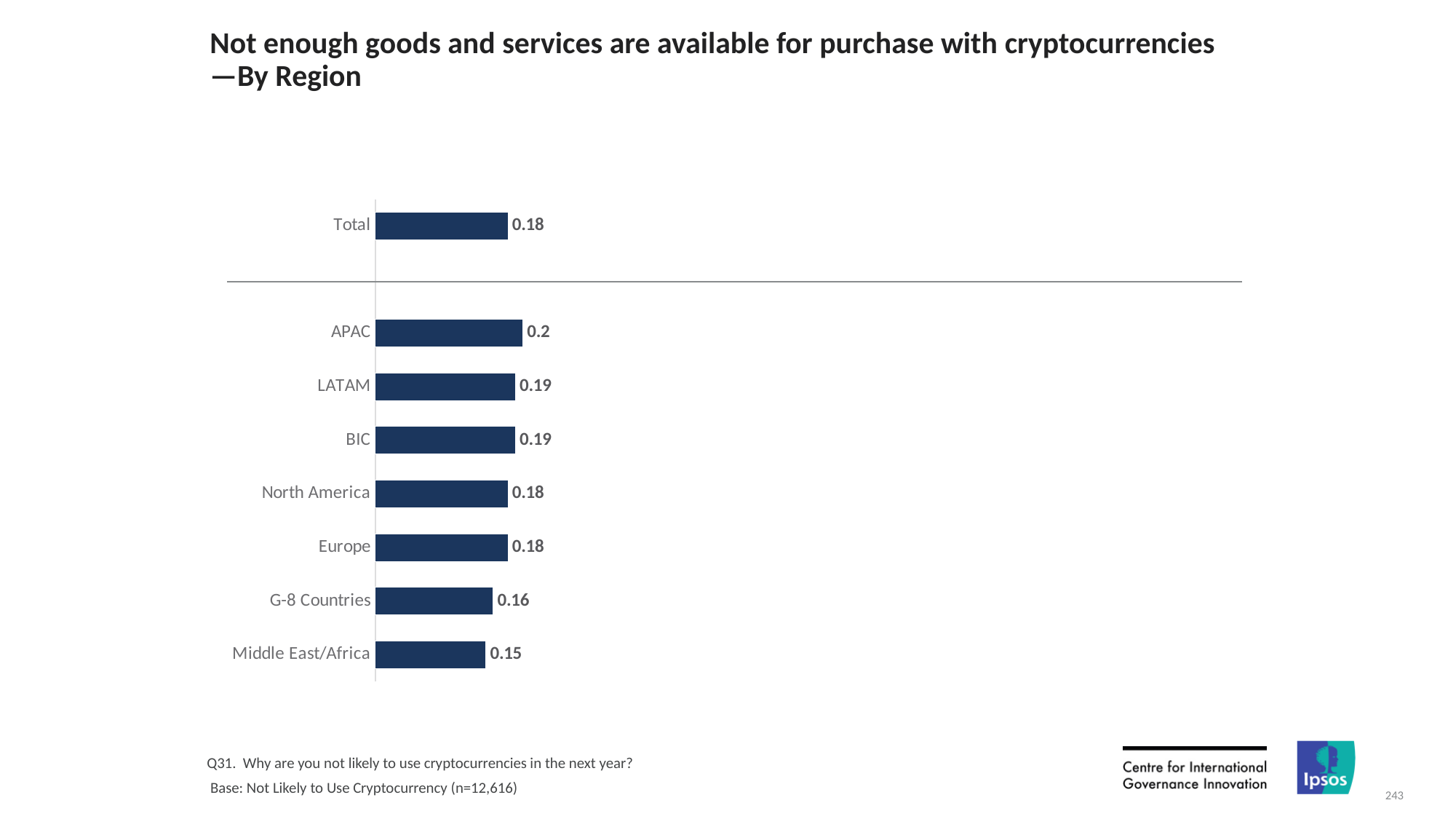
What is the value for Total? 0.18 What is the value for G-8 Countries? 0.16 What is the difference between the values for G-8 Countries and Europe? 0.02 Which region has the lowest value? Middle East/Africa What is the value for APAC? 0.2 What kind of chart is shown on the slide? Bar chart Which is larger, the value for APAC or the value for G-8 Countries? APAC How many bars are shown in the chart, including Total? 8 What is the difference between the values for APAC and Middle East/Africa? 0.05 What is the value for Middle East/Africa? 0.15 Which region has the highest value? APAC What is the value for LATAM? 0.19